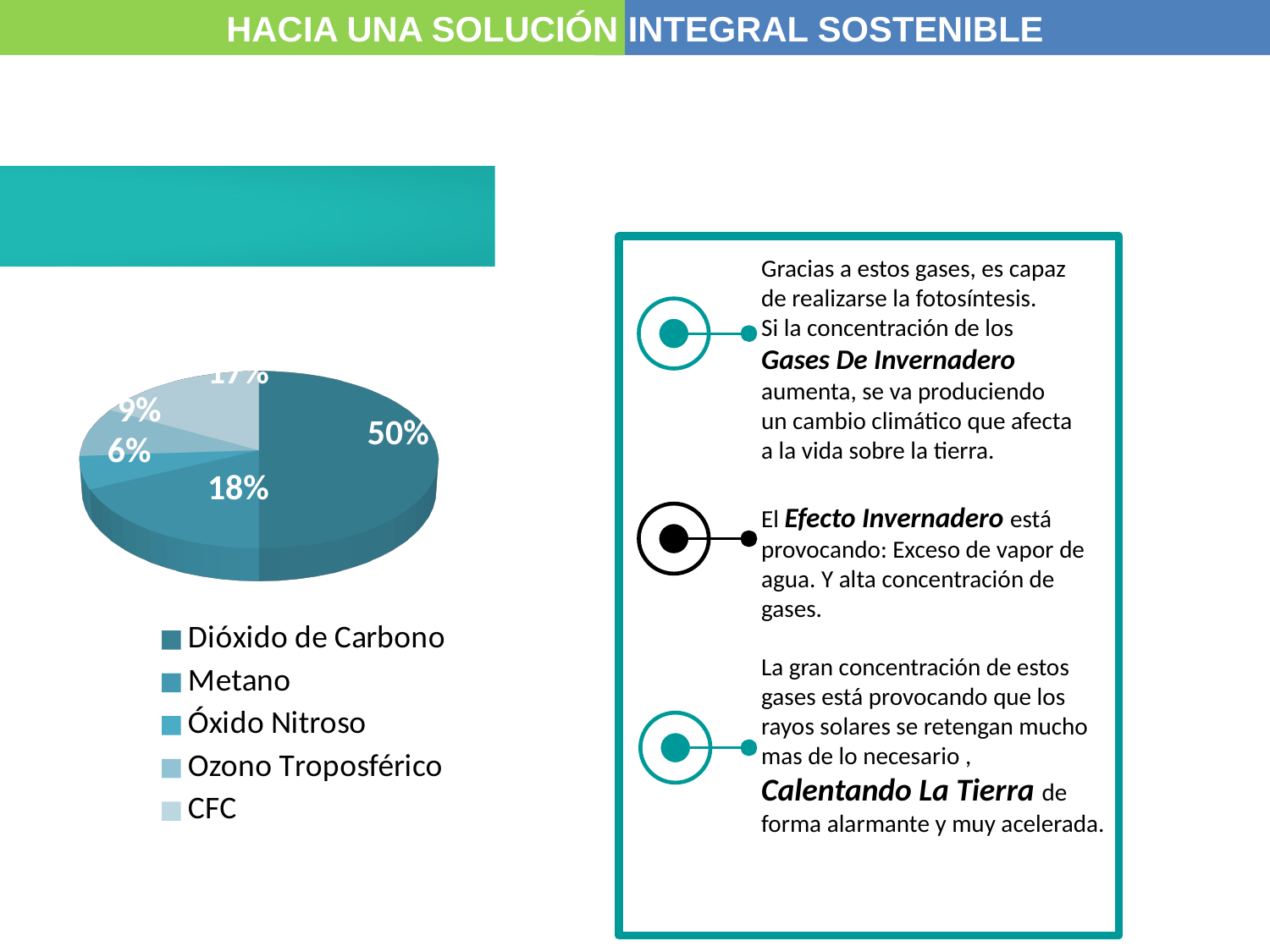
Which is larger in the pie chart, Metano or Ozono Troposférico? Metano What percentage does the pie chart show for Dióxido de Carbono? 50% What percentage does the pie chart show for Ozono Troposférico? 9% How many slices does the pie chart have? 5 Which entry is listed last in the pie chart's legend? CFC Which gas has the largest slice in the pie chart? Dióxido de Carbono Which gas has the smallest slice in the pie chart? Óxido Nitroso What kind of chart is shown on the left of the slide? Pie chart What is the difference in percentage points between Ozono Troposférico and Óxido Nitroso in the pie chart? 3 What percentage does the pie chart show for Metano? 18% What is the difference in percentage points between Dióxido de Carbono and Metano in the pie chart? 32 What percentage does the pie chart show for Óxido Nitroso? 6%